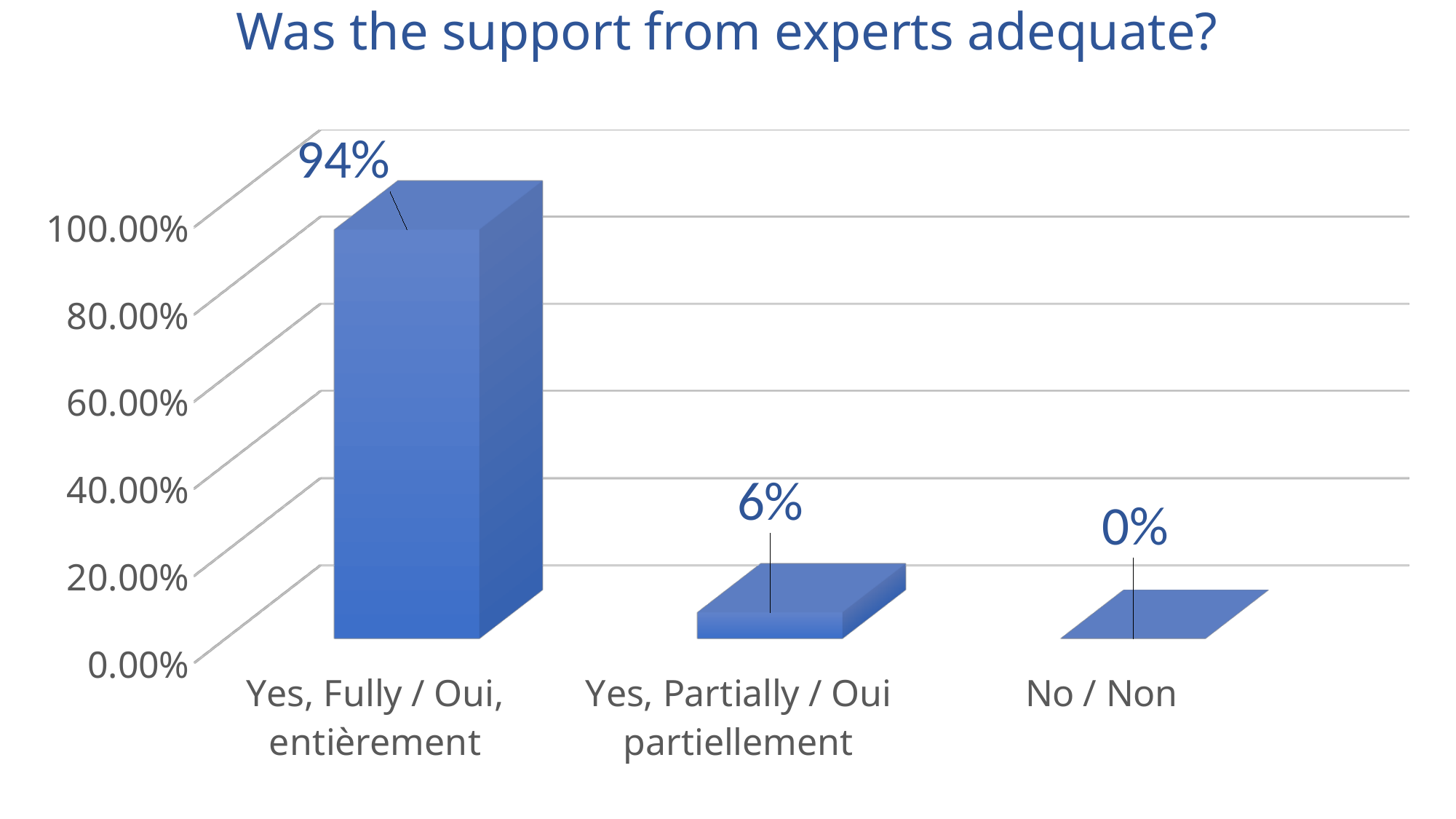
Which category has the lowest value? No / Non What is the difference between the values for "Yes, Fully / Oui, entièrement" and "Yes, Partially / Oui partiellement"? 88% Which is larger, the value for "Yes, Partially / Oui partiellement" or the value for "No / Non"? Yes, Partially / Oui partiellement Is the value for "Yes, Partially / Oui partiellement" greater or less than 20.00%? less What is the value for "Yes, Partially / Oui partiellement"? 6% What is the title of the chart? Was the support from experts adequate? How many categories are shown on the x axis? 3 What kind of chart is shown on the slide? bar chart Is the value for "Yes, Fully / Oui, entièrement" greater or less than 80.00%? greater Which category has the highest value? Yes, Fully / Oui, entièrement What is the value for "No / Non"? 0% What is the value for "Yes, Fully / Oui, entièrement"? 94%